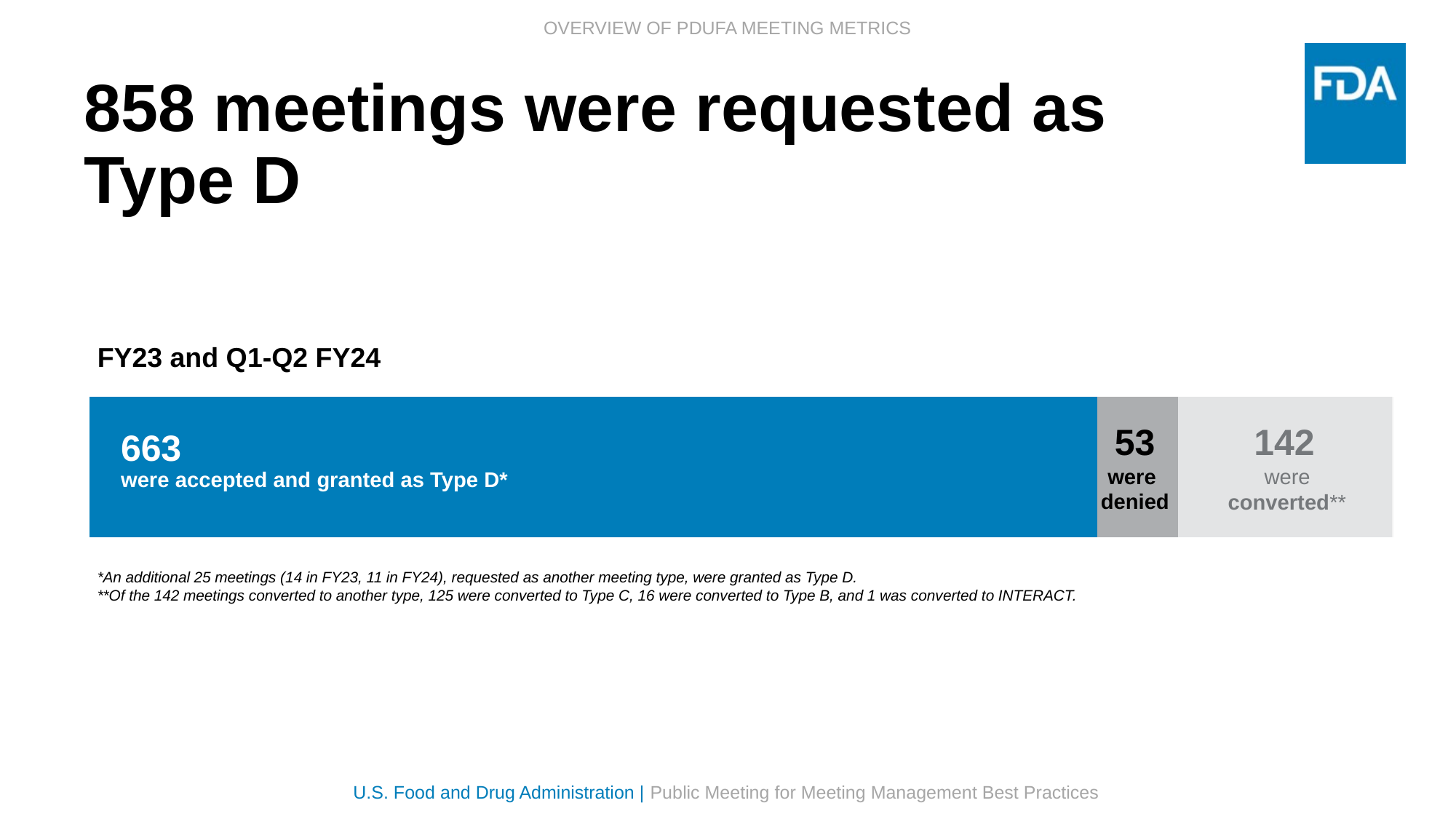
What is the total of all segments in the stacked bar? 858 How many segments make up the stacked bar? 3 Which outcome segment of the bar has the largest value? were accepted and granted as Type D What kind of chart is shown on the slide? stacked bar chart Which outcome segment of the bar has the smallest value? were denied What is the difference between the number of meetings converted and the number denied? 89 How many Type D meeting requests were denied? 53 How many Type D meeting requests were accepted and granted as Type D? 663 What is the difference between the number of meetings accepted as Type D and the number converted? 521 Which is larger: the number of meetings denied or the number converted? converted How many Type D meeting requests were converted to another type? 142 What time period does the bar chart cover, according to its label? FY23 and Q1-Q2 FY24